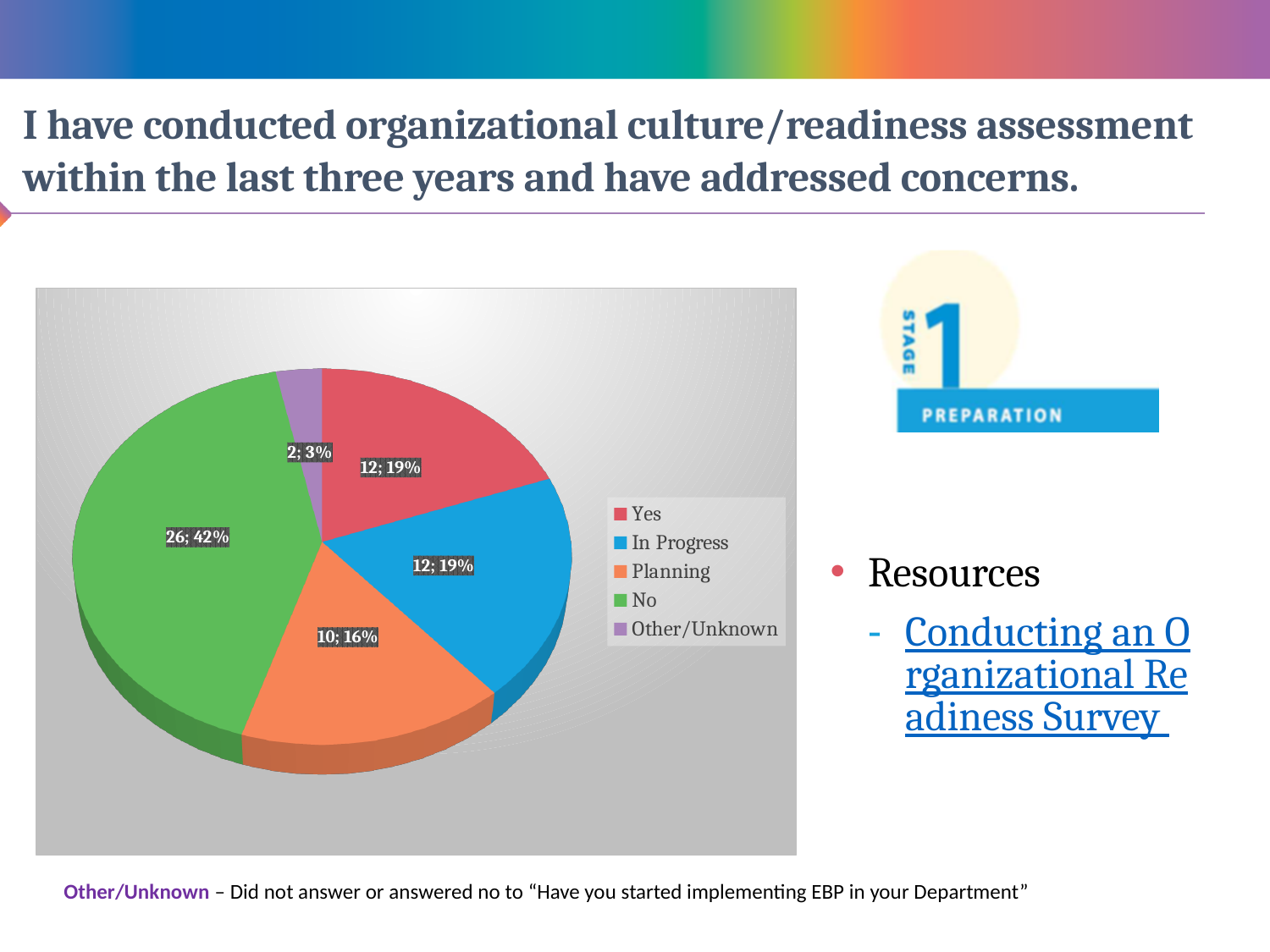
What is the count and percentage shown for the "No" slice? 26; 42% What kind of chart is shown on the slide? pie chart What is the count and percentage shown for the "Planning" slice? 10; 16% How many categories does the pie chart's legend list? 5 What is the difference in count between the "No" slice and the "Planning" slice? 16 Which is larger, the "Planning" slice or the "Yes" slice? Yes What is the count shown for the "Yes" slice? 12 Which category has the smallest slice of the pie? Other/Unknown Which category has the largest slice of the pie? No What share of the pie does the "In Progress" slice represent? 19% What is the count and percentage shown for the "Other/Unknown" slice? 2; 3% What colour is the "No" slice in the pie chart? green